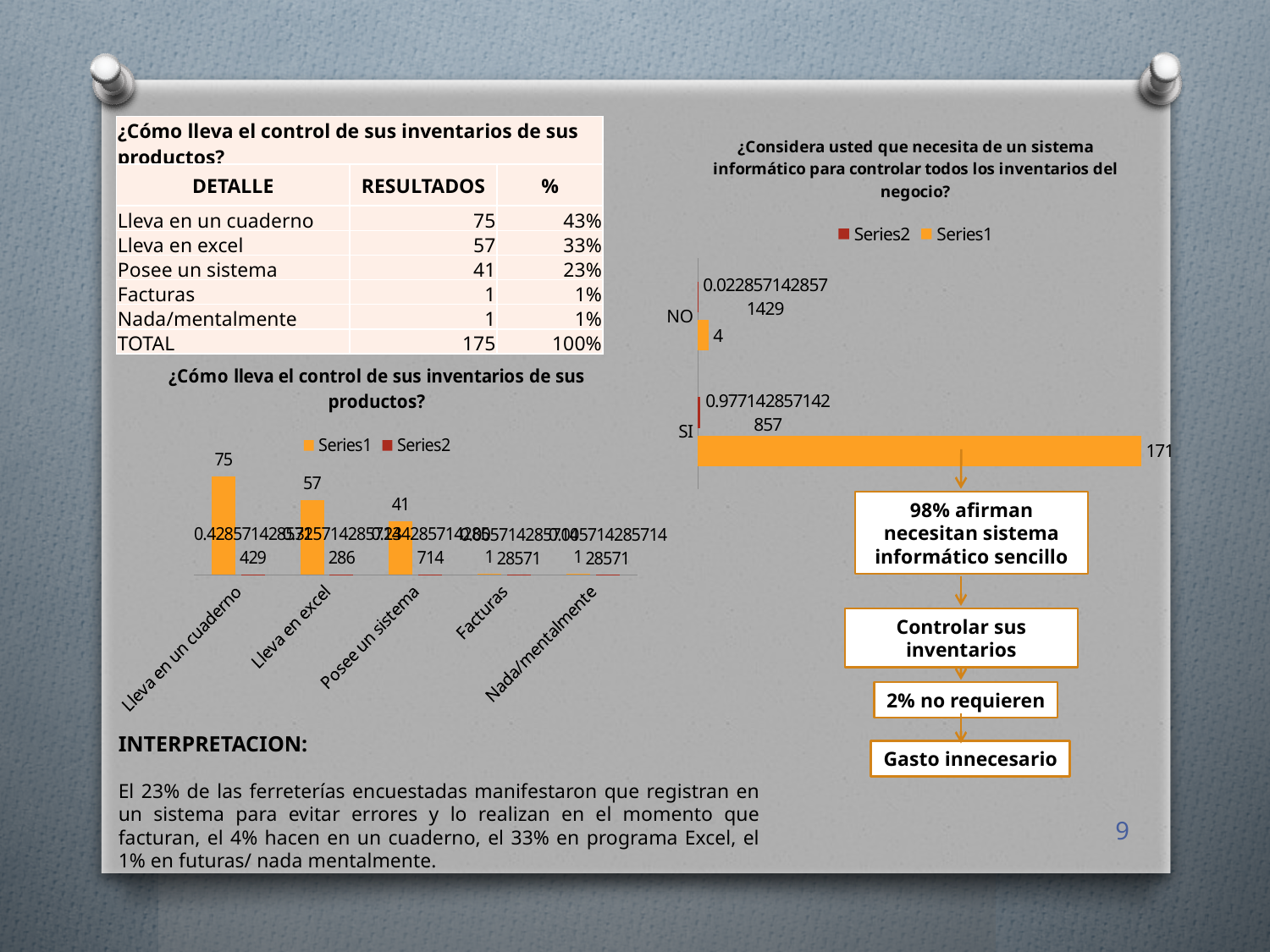
In the chart titled '¿Cómo lleva el control de sus inventarios de sus productos?', which category has the highest Series1 value? Lleva en un cuaderno In the chart titled '¿Considera usted que necesita de un sistema informático para controlar todos los inventarios del negocio?', what is the Series1 value for 'SI'? 171 In the chart titled '¿Cómo lleva el control de sus inventarios de sus productos?', what is the difference between the Series1 values for 'Lleva en un cuaderno' and 'Lleva en excel'? 18 In the chart titled '¿Considera usted que necesita de un sistema informático para controlar todos los inventarios del negocio?', which category has the larger Series1 value, 'SI' or 'NO'? SI In the chart titled '¿Cómo lleva el control de sus inventarios de sus productos?', how many categories are shown on the x axis? 5 In the chart titled '¿Cómo lleva el control de sus inventarios de sus productos?', what is the Series1 value for 'Posee un sistema'? 41 In the chart titled '¿Cómo lleva el control de sus inventarios de sus productos?', what is the Series1 value for 'Lleva en excel'? 57 What kind of chart is the one titled '¿Cómo lleva el control de sus inventarios de sus productos?'? Bar chart In the chart titled '¿Considera usted que necesita de un sistema informático para controlar todos los inventarios del negocio?', what is the Series1 value for 'NO'? 4 In the chart titled '¿Cómo lleva el control de sus inventarios de sus productos?', what is the Series1 value for 'Lleva en un cuaderno'? 75 In the chart titled '¿Cómo lleva el control de sus inventarios de sus productos?', how many series does the legend list? 2 In the chart titled '¿Considera usted que necesita de un sistema informático para controlar todos los inventarios del negocio?', what is the difference between the Series1 values for 'SI' and 'NO'? 167